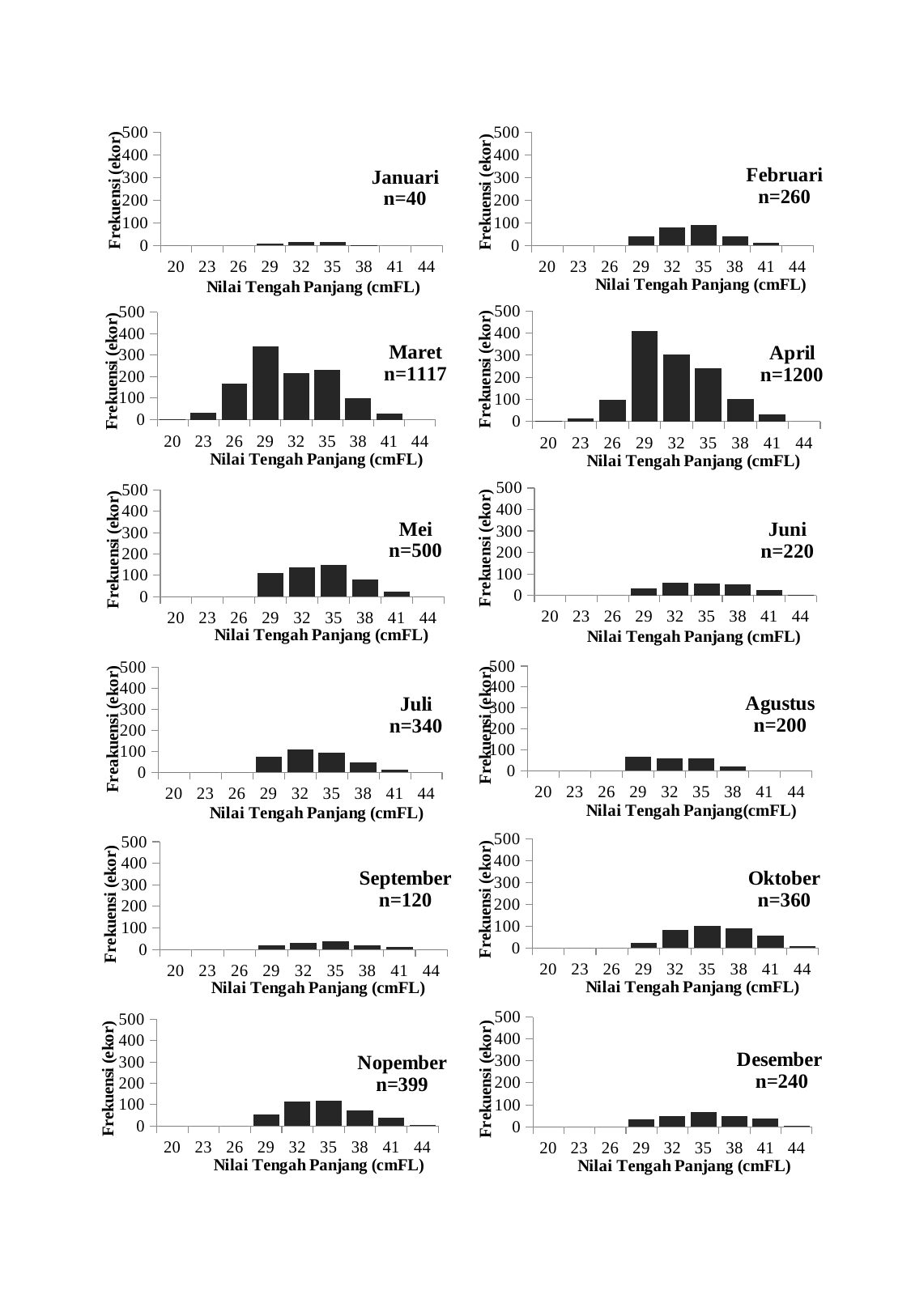
What kind of chart is used for each month on the slide? bar chart In the April chart, which length class (cmFL) has the highest frequency? 29 In the Maret chart, is the frequency for the 26 cmFL class greater or less than 100? greater In the Maret chart, is the frequency for the 29 cmFL class greater or less than 300? greater In the Maret chart, which length class (cmFL) has the highest frequency? 29 In the Mei chart, which length class (cmFL) has the highest frequency? 35 What sample size is printed on the Maret chart? n=1117 In the April chart, which has the larger frequency, the 32 cmFL class or the 35 cmFL class? 32 How many monthly charts are shown on the slide? 12 In the Mei chart, is the frequency for the 38 cmFL class greater or less than 100? less